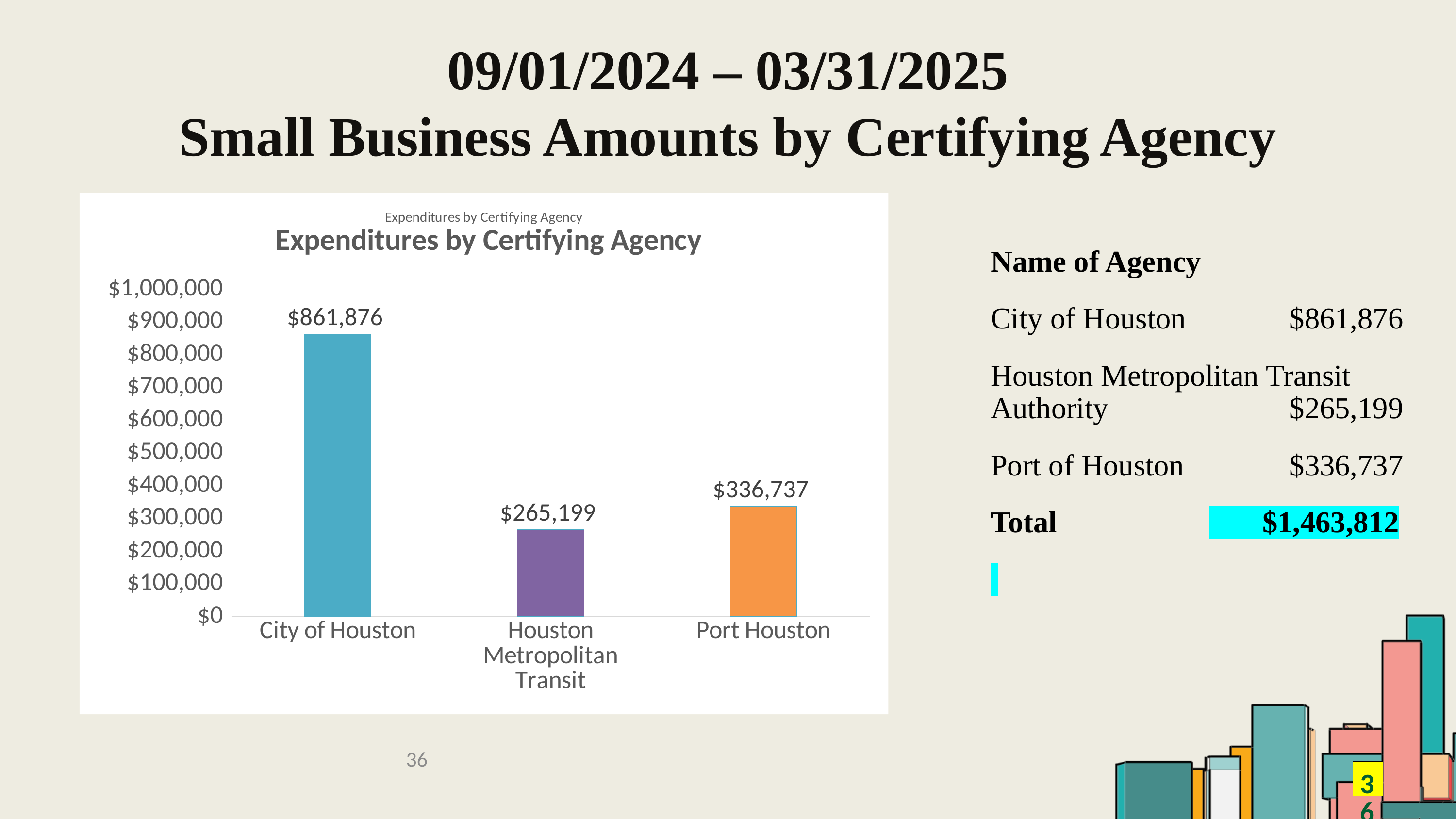
What is the value for City of Houston? $861,876 How many categories are shown on the chart? 3 What is the title of the chart? Expenditures by Certifying Agency What is the value for Port Houston? $336,737 Which category has the highest value? City of Houston Which is larger, the value for Port Houston or the value for Houston Metropolitan Transit? Port Houston What kind of chart is shown? bar chart What is the difference between the values for Port Houston and Houston Metropolitan Transit? $71,538 Is the value for City of Houston greater or less than $800,000? greater What is the value for Houston Metropolitan Transit? $265,199 What is the difference between the values for City of Houston and Port Houston? $525,139 Which category has the lowest value? Houston Metropolitan Transit